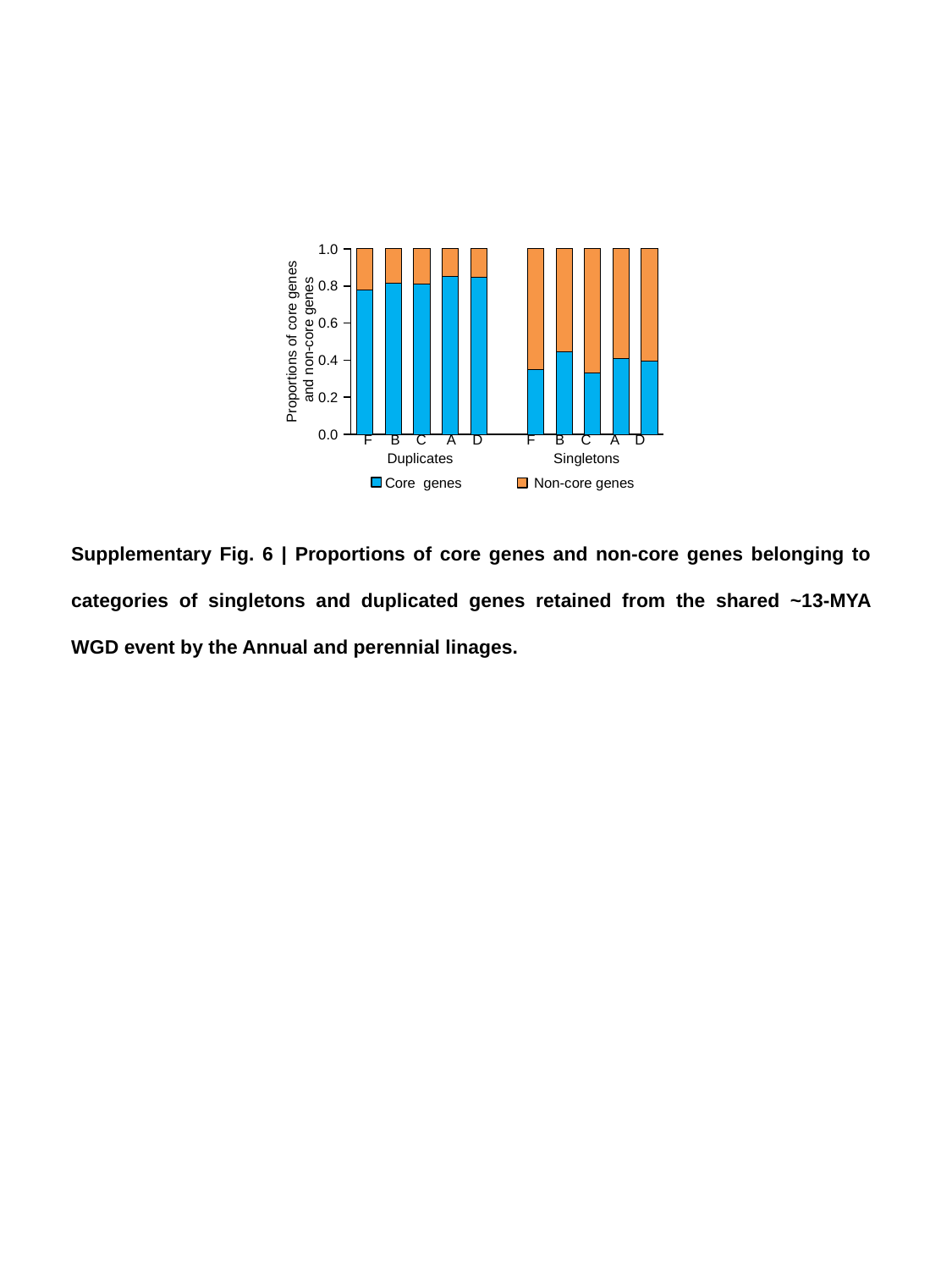
What are the two series named in the legend? Core genes and Non-core genes Is the Core genes proportion for F in the Duplicates group greater or less than 0.6? greater What is the label of the y axis? Proportions of core genes and non-core genes What is the total height of each stacked bar? 1.0 Is the Core genes proportion for C in the Singletons group greater or less than 0.4? less Within the Singletons group, which category has the highest Core genes proportion? B Which has the larger Core genes proportion: F in the Duplicates group or F in the Singletons group? F in the Duplicates group What kind of chart is shown on the slide? Stacked bar chart How many series does the legend list? 2 How many bars are plotted in the chart in total? 10 Is the Core genes proportion for B in the Singletons group greater or less than 0.4? greater How many bars are in the Singletons group? 5